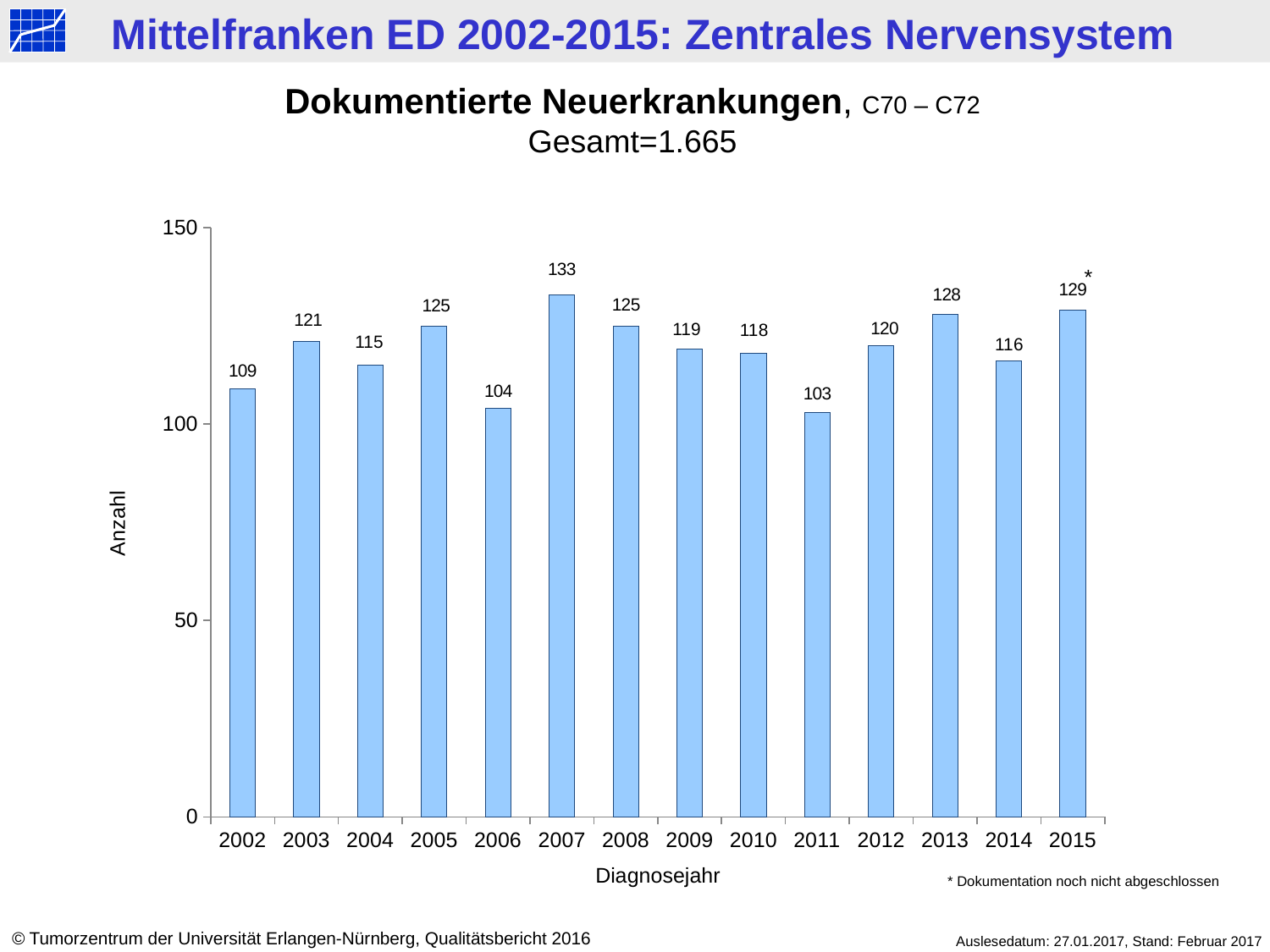
How many diagnosis years are shown on the x axis? 14 What is the number of documented new cases in 2007? 133 What total (Gesamt) is stated in the chart subtitle? 1.665 Which diagnosis year has the lowest number of new cases? 2011 What is the difference between the values for 2007 and 2006? 29 What is the value shown for the year 2011? 103 Which year has a larger value, 2013 or 2014? 2013 What is the label of the y axis? Anzahl Is the value for 2006 greater or less than 100? greater Do the values rise or fall from 2011 to 2013? rise What kind of chart is shown on the slide? bar chart Which diagnosis year has the highest number of new cases? 2007